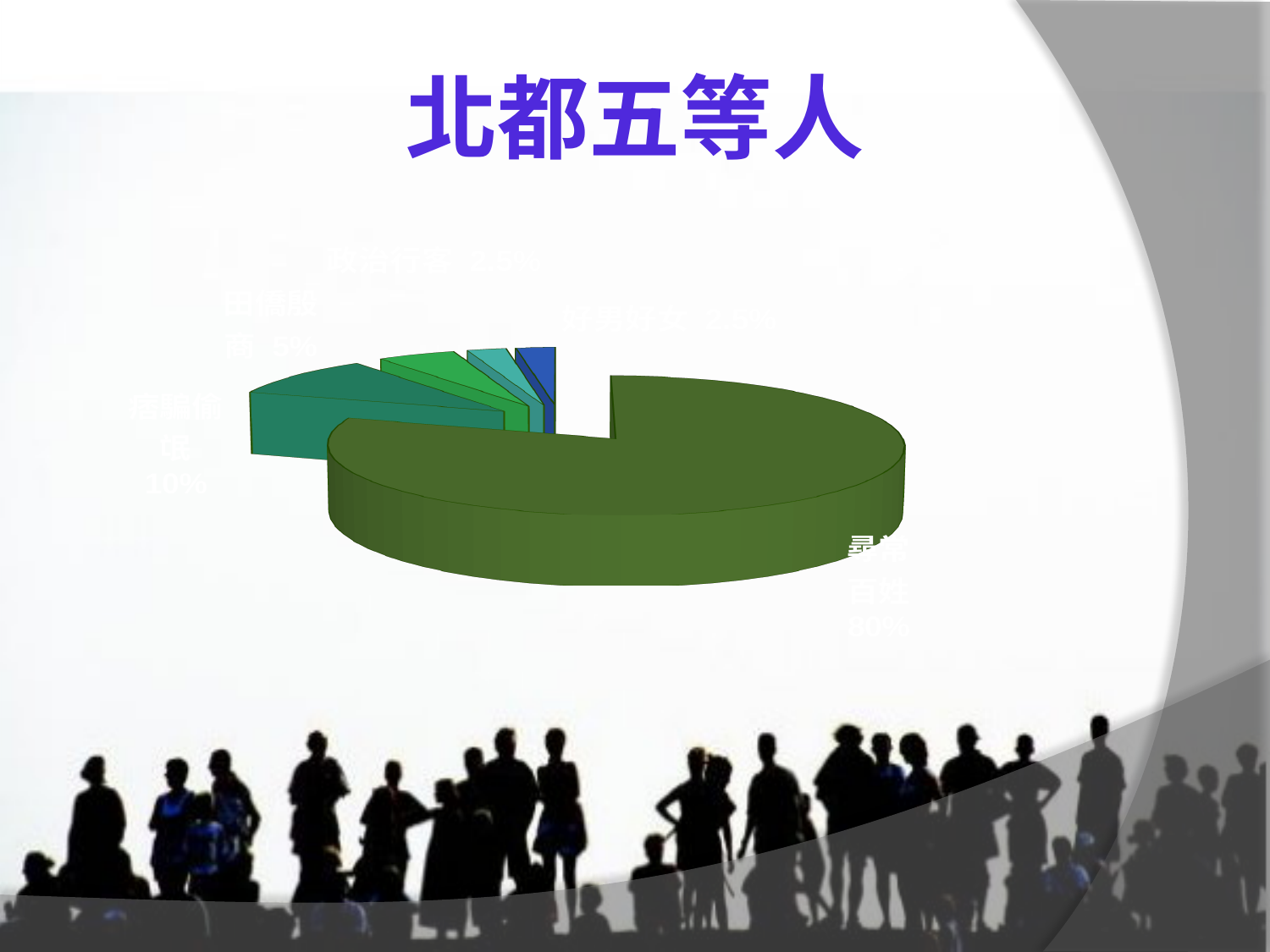
What share of the pie is 田僑殷商? 5% What is the title of the chart? 北都五等人 Which category has the largest slice of the pie? 尋常百姓 What share of the pie is 好男好女? 2.5% Is the share of 尋常百姓 greater or less than 50%? greater How many slices does the pie chart have? 5 What is the difference between the shares of 田僑殷商 and 政治行客? 2.5% What share of the pie is 尋常百姓? 80% What kind of chart is shown on the slide? pie chart